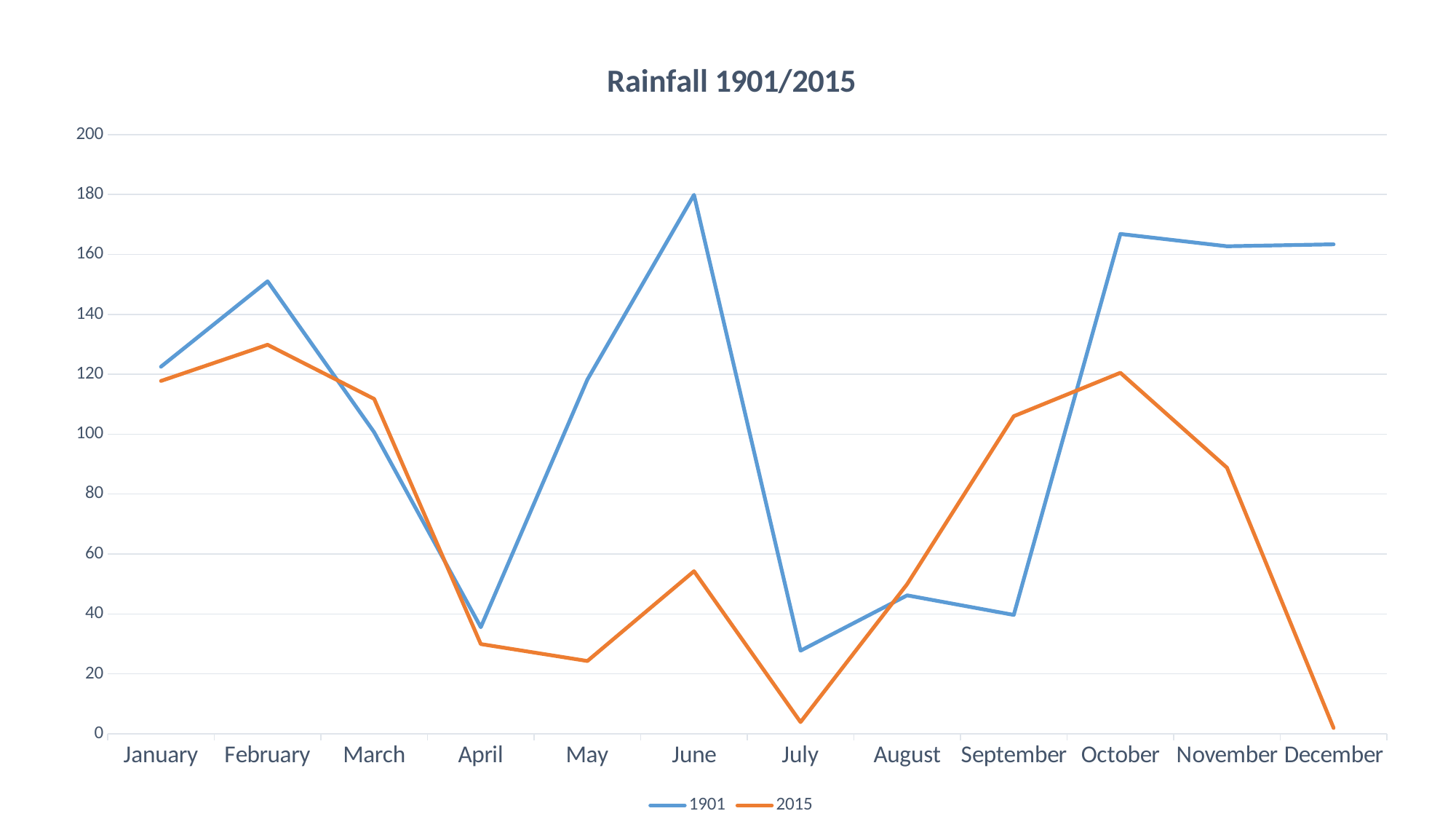
Is the value for 1901 in June greater or less than 160? greater What kind of chart is shown on the slide? line chart Does the 2015 series rise or fall from October to December? fall In which month is the 1901 series lowest? July Is the value for 2015 in December greater or less than 20? less Which series has the larger value in September, 1901 or 2015? 2015 In which month is the 2015 series highest? February How many series does the legend list? 2 What is the title of the chart? Rainfall 1901/2015 How many months are shown on the x axis? 12 In which month is the 1901 series highest? June Is the value for 2015 in July greater or less than 20? less